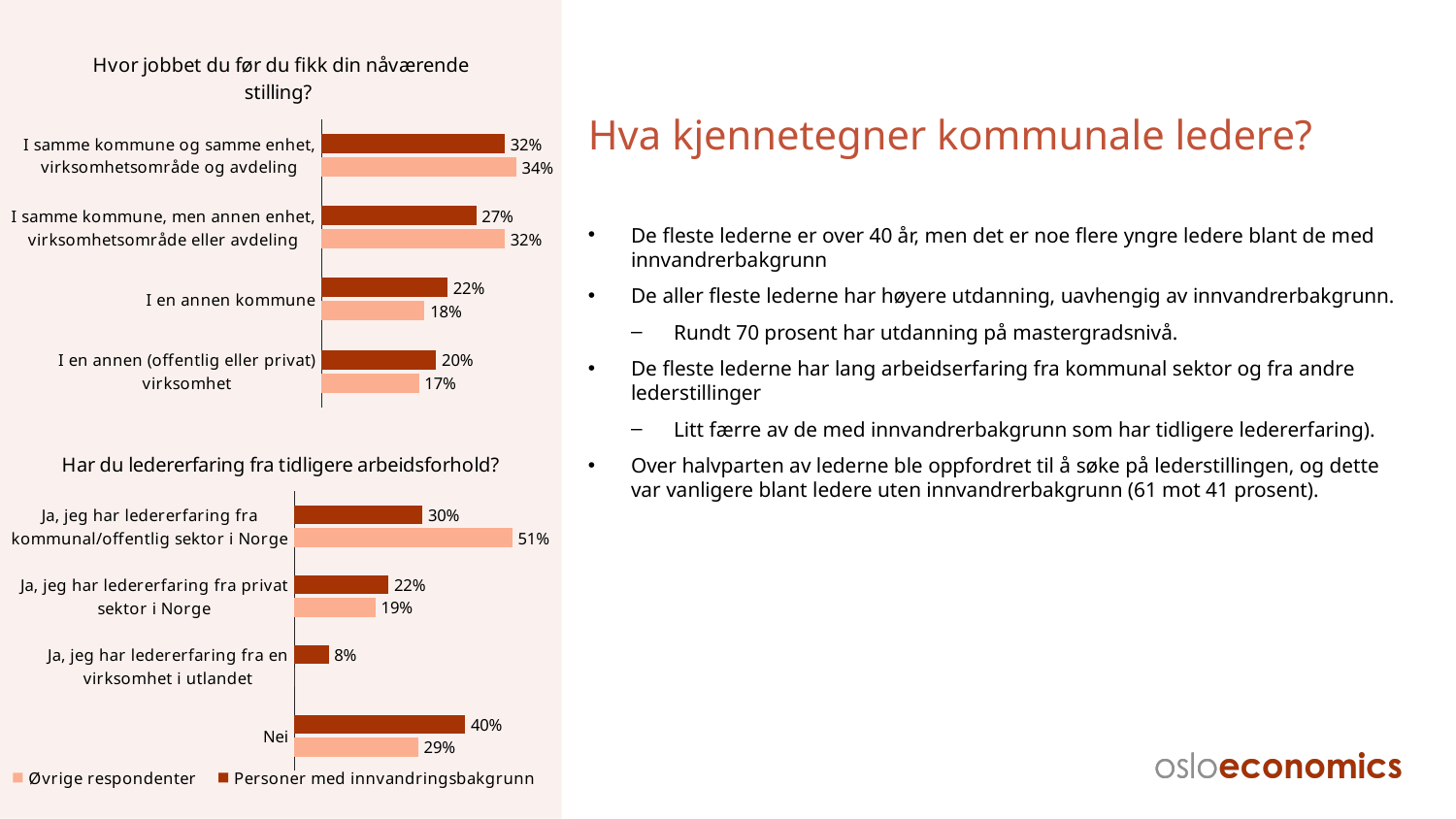
In the chart 'Har du ledererfaring fra tidligere arbeidsforhold?', which category has the lowest value for 'Personer med innvandringsbakgrunn'? Ja, jeg har ledererfaring fra en virksomhet i utlandet In the chart 'Har du ledererfaring fra tidligere arbeidsforhold?', what is the value for 'Personer med innvandringsbakgrunn' in the category 'Nei'? 40% In the chart 'Hvor jobbet du før du fikk din nåværende stilling?', what is the value for 'Personer med innvandringsbakgrunn' in the category 'I samme kommune og samme enhet, virksomhetsområde og avdeling'? 32% In the chart 'Hvor jobbet du før du fikk din nåværende stilling?', which category has the highest value for 'Øvrige respondenter'? I samme kommune og samme enhet, virksomhetsområde og avdeling In the chart 'Har du ledererfaring fra tidligere arbeidsforhold?', which is larger for 'Ja, jeg har ledererfaring fra privat sektor i Norge': 'Øvrige respondenter' or 'Personer med innvandringsbakgrunn'? Personer med innvandringsbakgrunn In the chart 'Hvor jobbet du før du fikk din nåværende stilling?', what is the difference between 'Øvrige respondenter' and 'Personer med innvandringsbakgrunn' for 'I samme kommune, men annen enhet, virksomhetsområde eller avdeling'? 5 percentage points In the chart 'Har du ledererfaring fra tidligere arbeidsforhold?', what is the difference between 'Øvrige respondenter' and 'Personer med innvandringsbakgrunn' for 'Nei'? 11 percentage points In the chart 'Hvor jobbet du før du fikk din nåværende stilling?', what is the value for 'Øvrige respondenter' in the category 'I en annen kommune'? 18% In the chart 'Hvor jobbet du før du fikk din nåværende stilling?', how many categories are shown? 4 How many series does the legend on the slide list? 2 In the chart 'Har du ledererfaring fra tidligere arbeidsforhold?', what is the value for 'Øvrige respondenter' in the category 'Ja, jeg har ledererfaring fra kommunal/offentlig sektor i Norge'? 51% What type of chart is 'Har du ledererfaring fra tidligere arbeidsforhold?'? Bar chart